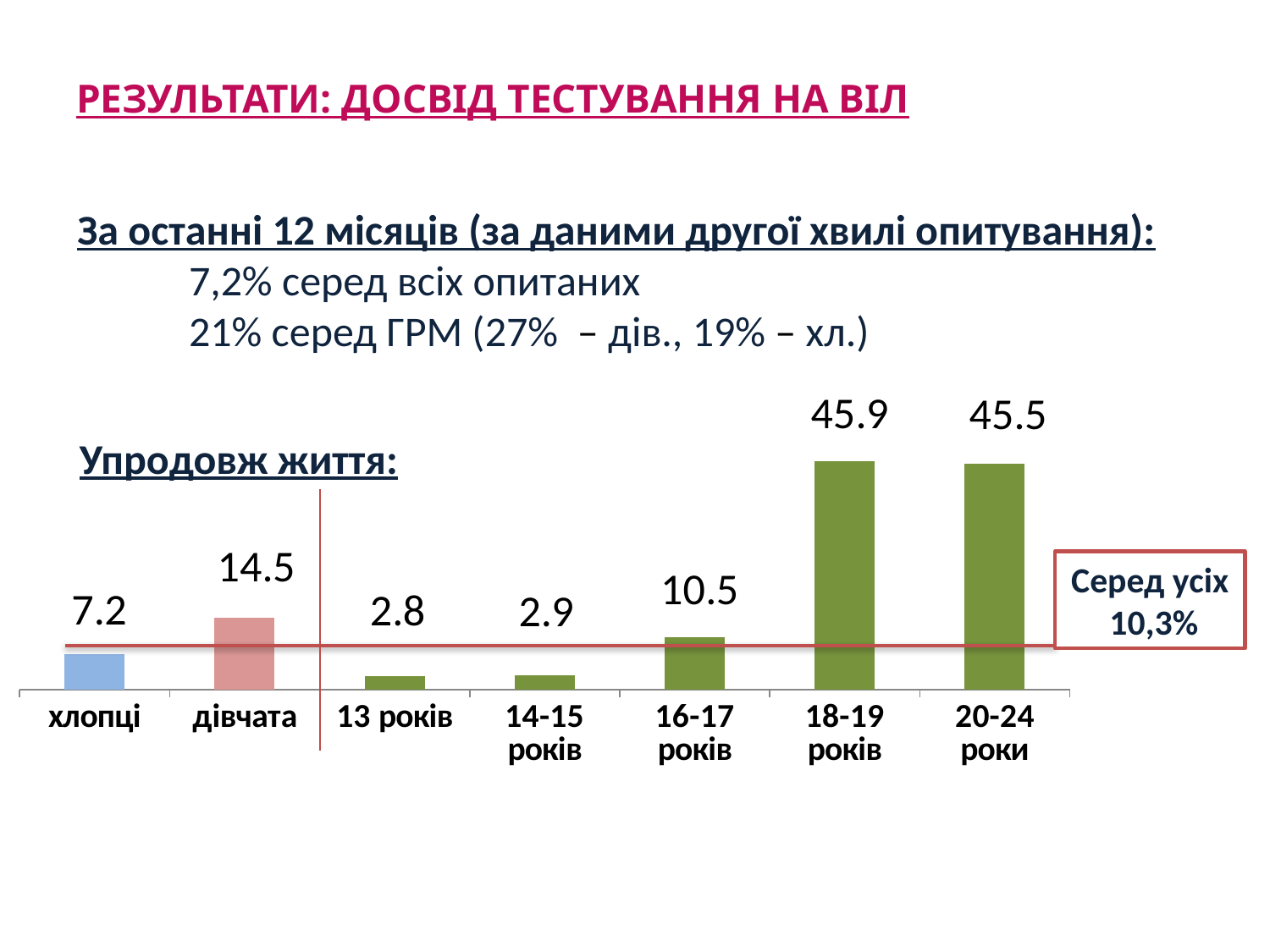
How many categories are shown on the x axis of the bar chart? 7 Which is larger, the value for 14-15 років or the value for 16-17 років? 16-17 років What value is shown for the 20-24 роки category? 45.5 What is the difference between the values for дівчата and хлопці? 7.3 What value does the red horizontal line labelled 'Серед усіх' represent? 10,3% Which category has the lowest value in the bar chart? 13 років What value is shown for the 16-17 років category? 10.5 What type of chart is shown on the slide? bar chart What value is shown for дівчата in the bar chart? 14.5 Which category has the highest value in the bar chart? 18-19 років What value is shown for хлопці in the bar chart? 7.2 What is the difference between the values for 18-19 років and 16-17 років? 35.4